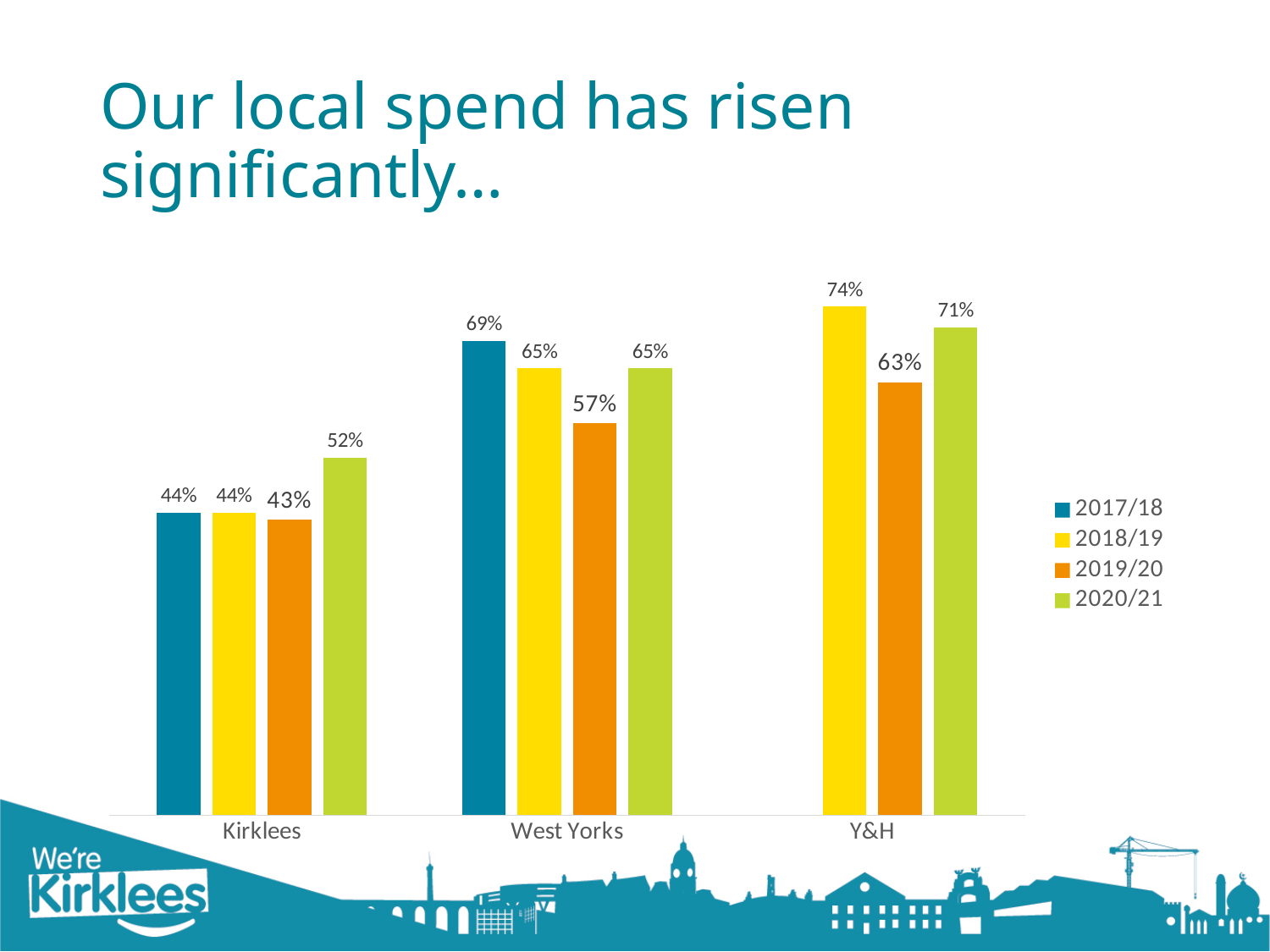
How many categories are shown on the x axis? 3 What is the difference between the Kirklees values for 2020/21 and 2019/20? 9% Which year has the lowest value for Kirklees? 2019/20 What is the value for West Yorks in 2017/18? 69% Which category has the highest value in 2020/21? Y&H How many series does the legend list? 4 What is the value for West Yorks in 2019/20? 57% What kind of chart is shown on the slide? Bar chart What is the value for Y&H in 2018/19? 74% Which is larger, the West Yorks value for 2017/18 or the Y&H value for 2020/21? Y&H 2020/21 What is the value for Kirklees in 2020/21? 52% What is the difference between the Y&H values for 2018/19 and 2019/20? 11%